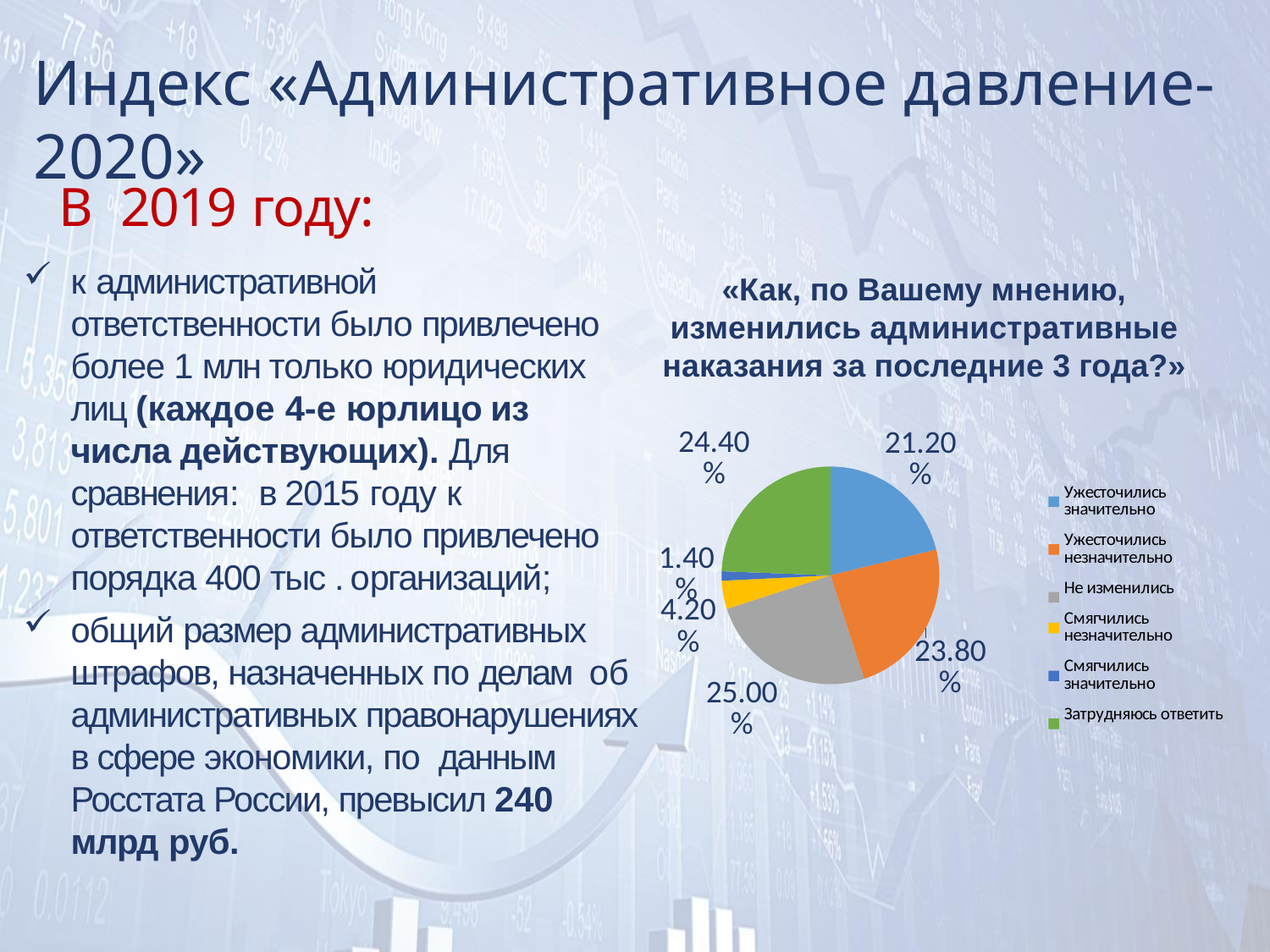
Which answer option has the largest share of the pie? Не изменились Which is larger: the share for «Ужесточились незначительно» or the share for «Смягчились незначительно»? Ужесточились незначительно What kind of chart is shown on the slide? pie chart What share of respondents answered «Ужесточились незначительно»? 23.80% What is the difference between the shares for «Не изменились» and «Ужесточились значительно»? 3.80% What share of respondents answered «Смягчились незначительно»? 4.20% What share of respondents answered «Ужесточились значительно»? 21.20% What share of respondents answered «Не изменились»? 25.00% What colour is the slice for «Затрудняюсь ответить»? green Which answer option has the smallest share of the pie? Смягчились значительно What share of respondents answered «Затрудняюсь ответить»? 24.40% How many answer options does the legend of the pie chart list? 6